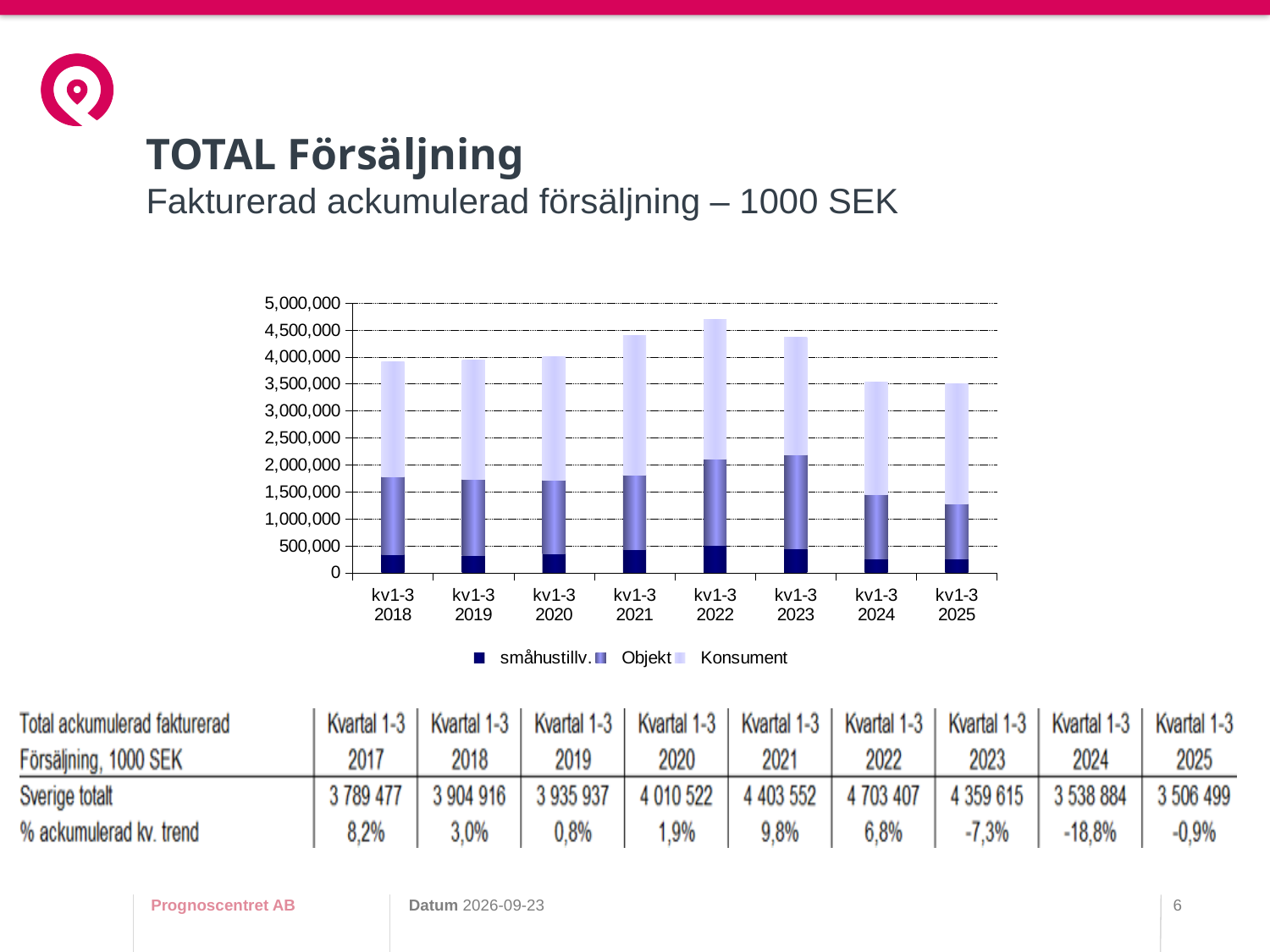
Is the total bar for kv1-3 2025 greater or less than 4,000,000? less Which total bar is taller, kv1-3 2021 or kv1-3 2019? kv1-3 2021 Which series is shown in the lightest colour at the top of each stacked bar? Konsument Is the total bar for kv1-3 2021 greater or less than 4,000,000? greater Which period has the highest total bar in the chart? kv1-3 2022 What kind of chart is shown on the slide? Stacked bar chart How many series does the chart legend list? 3 Is the småhustillv. segment for kv1-3 2024 greater or less than 500,000? less Do the total bars rise or fall from kv1-3 2022 to kv1-3 2025? fall According to the table, what is the total (Sverige totalt) for Kvartal 1-3 2022? 4 703 407 How many bars (periods) are plotted in the chart? 8